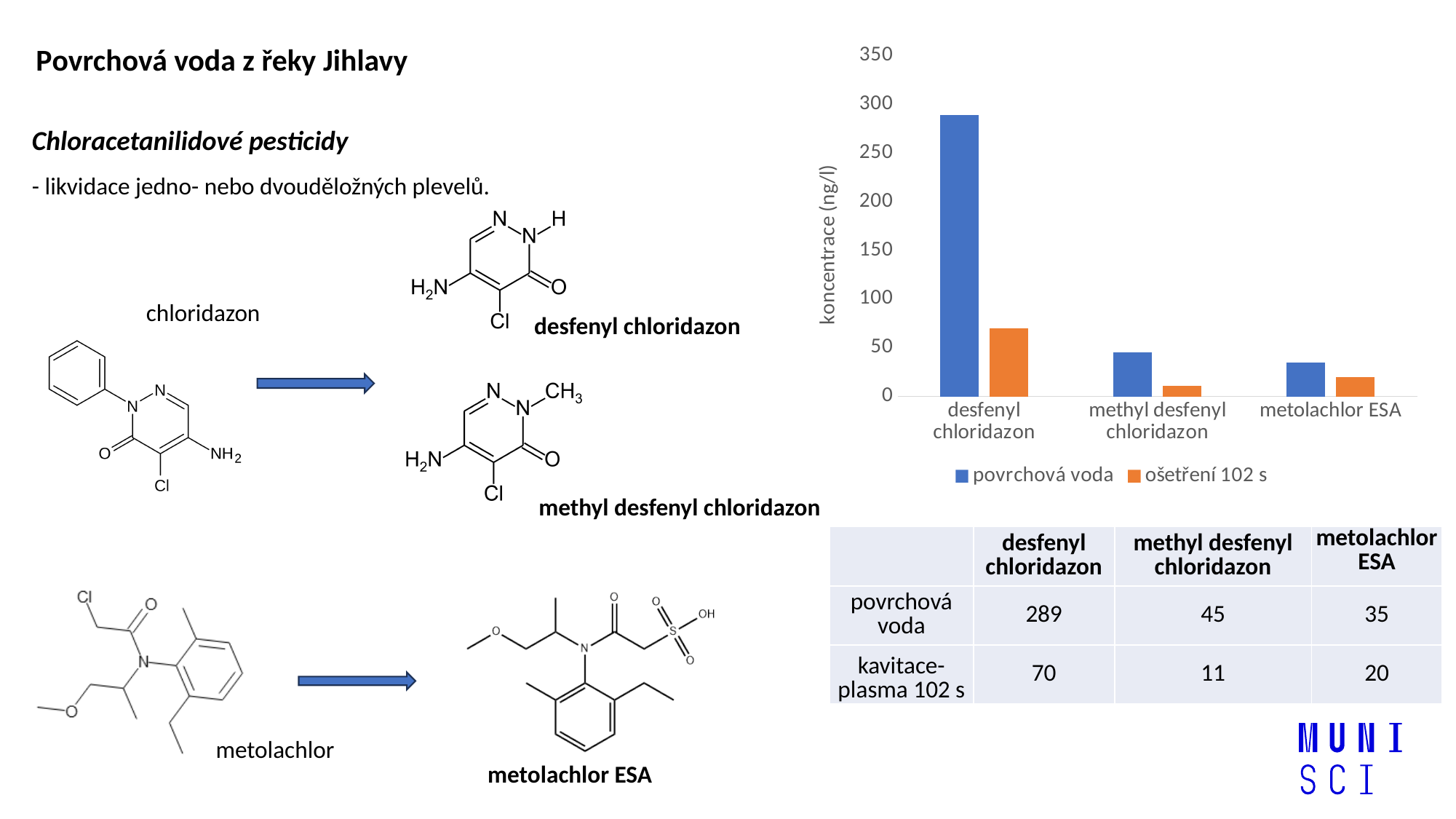
Is the povrchová voda value for desfenyl chloridazon greater or less than 250? greater Is the povrchová voda value for metolachlor ESA greater or less than 50? less What is the y-axis label of the chart? koncentrace (ng/l) For metolachlor ESA, which series has the larger value, povrchová voda or ošetření 102 s? povrchová voda Which category has the highest value for the povrchová voda series? desfenyl chloridazon What is the concentration of desfenyl chloridazon in povrchová voda according to the table? 289 How many categories are shown on the x axis of the chart? 3 Which category has the lowest value for the ošetření 102 s series? methyl desfenyl chloridazon Is the ošetření 102 s value for methyl desfenyl chloridazon greater or less than 50? less What type of chart is shown on the slide? bar chart How many series does the chart legend list? 2 Which colour represents the ošetření 102 s series in the chart? orange